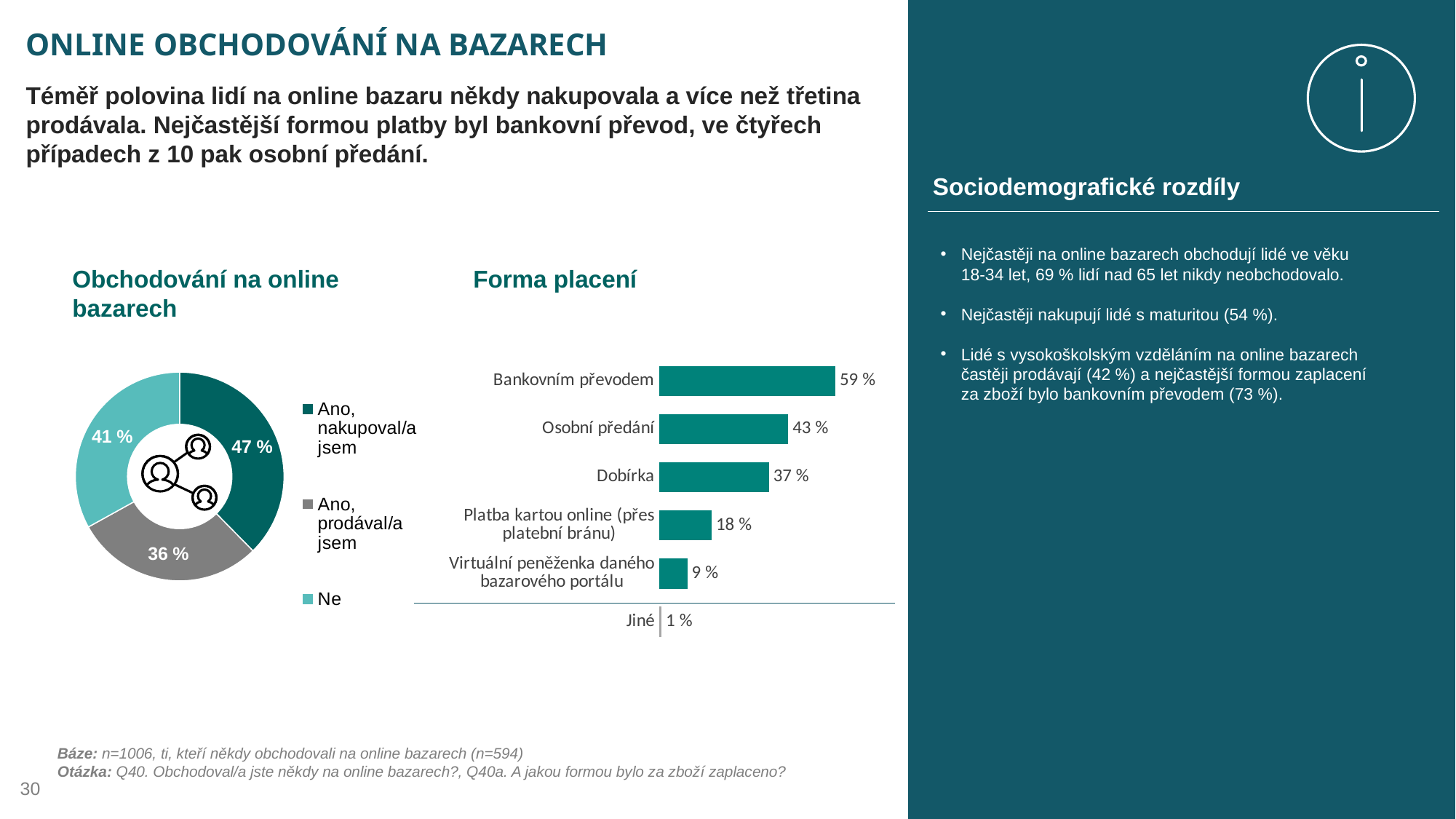
In the 'Forma placení' chart, which payment form has the lowest value? Jiné In the 'Forma placení' chart, which is larger: 'Dobírka' or 'Platba kartou online (přes platební bránu)'? Dobírka In the 'Forma placení' chart, which payment form has the highest value? Bankovním převodem In the 'Forma placení' chart, what is the difference between 'Bankovním převodem' and 'Dobírka'? 22 % In the 'Forma placení' chart, what is the value for 'Osobní předání'? 43 % In the 'Forma placení' chart, what is the value for 'Virtuální peněženka daného bazarového portálu'? 9 % In the 'Obchodování na online bazarech' chart, which category has the smallest share? Ano, prodával/a jsem How many categories does the legend of the 'Obchodování na online bazarech' chart list? 3 In the 'Obchodování na online bazarech' chart, what share is labelled for 'Ano, nakupoval/a jsem'? 47 % In the 'Obchodování na online bazarech' chart, what share is labelled for 'Ne'? 41 % How many categories are shown in the 'Forma placení' chart? 6 What kind of chart is 'Obchodování na online bazarech'? Doughnut (pie) chart